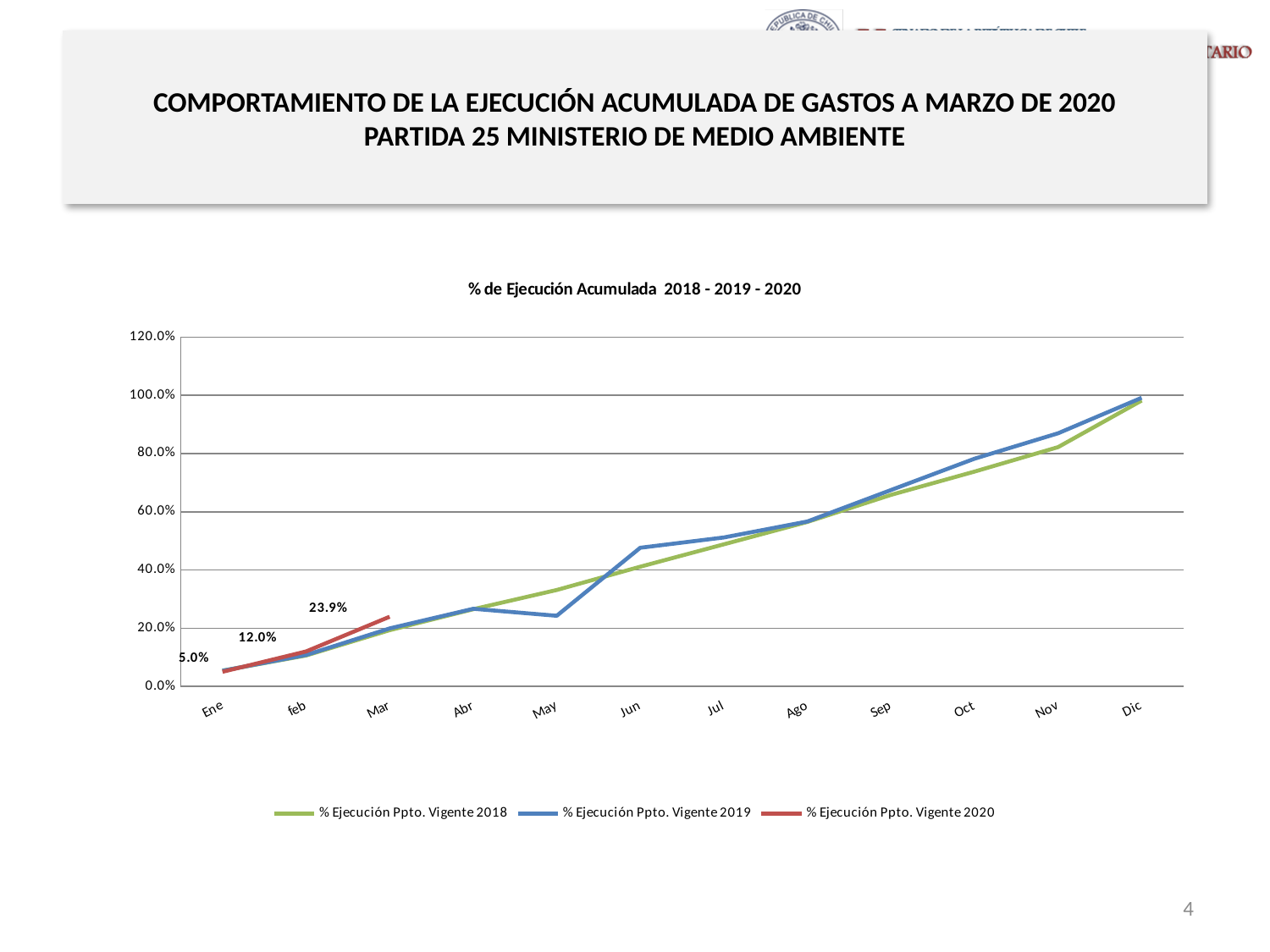
Is the value for % Ejecución Ppto. Vigente 2019 in Jun greater or less than 40.0%? greater What is the difference between the 2020 values for feb and Ene? 7.0% What is the value of % Ejecución Ppto. Vigente 2020 for Mar? 23.9% What is the difference between the 2020 values for Mar and feb? 11.9% Does the % Ejecución Ppto. Vigente 2019 line rise or fall from Ene to Dic? Rise How many months are shown on the x axis? 12 What is the value of % Ejecución Ppto. Vigente 2020 for feb? 12.0% In Jun, which series is higher: % Ejecución Ppto. Vigente 2018 or % Ejecución Ppto. Vigente 2019? % Ejecución Ppto. Vigente 2019 How many series does the legend list? 3 What is the title of the chart? % de Ejecución Acumulada 2018 - 2019 - 2020 What kind of chart is shown on the slide? Line chart What is the value of % Ejecución Ppto. Vigente 2020 for Ene? 5.0%